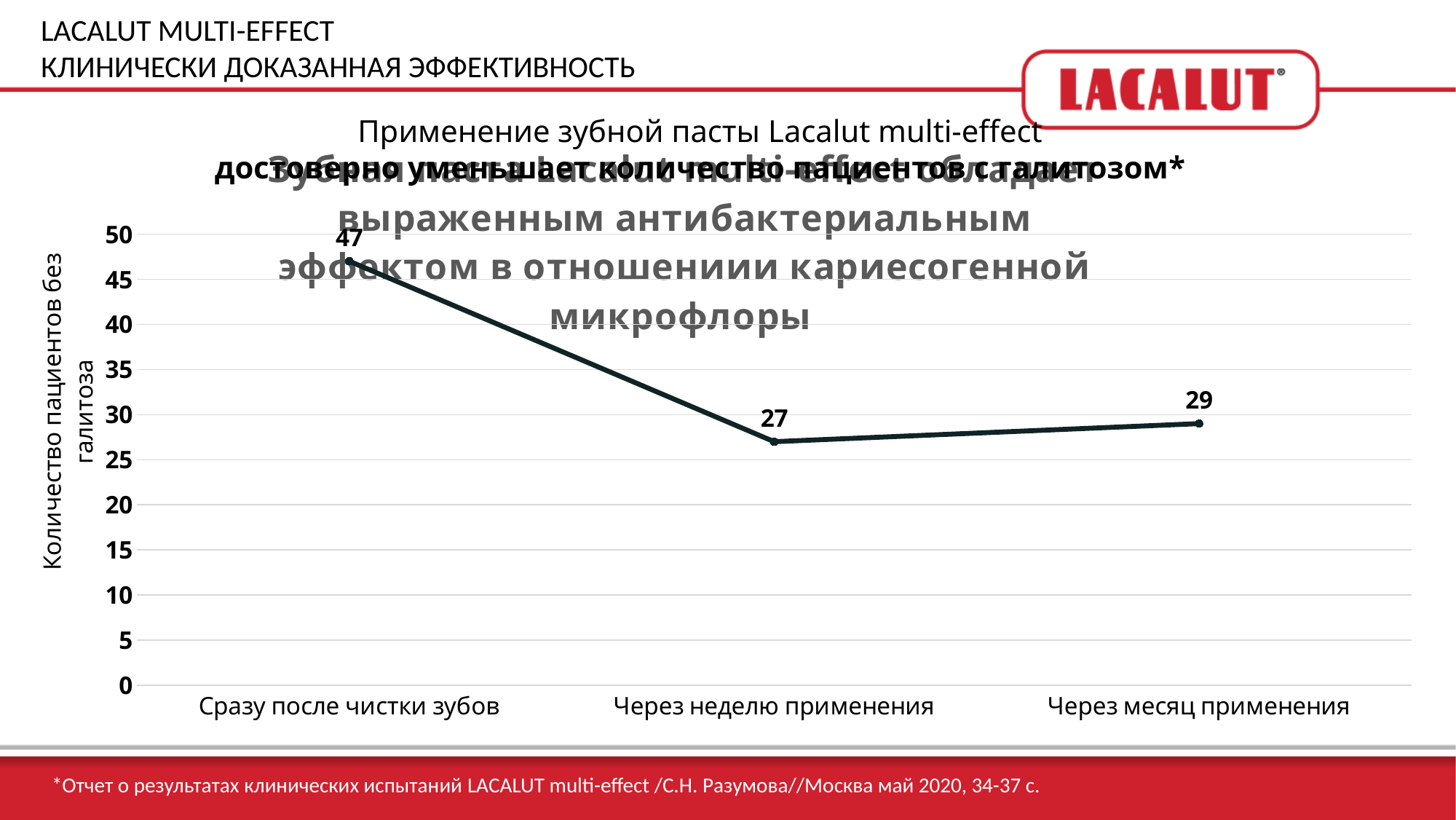
What is the difference between the values for "Через месяц применения" and "Через неделю применения"? 2 Is the value for "Через неделю применения" greater or less than 30? less What is the value for "Через месяц применения"? 29 How many data points are plotted on the chart? 3 What is the label of the vertical axis? Количество пациентов без галитоза Which category has the highest value? Сразу после чистки зубов What is the value for "Через неделю применения"? 27 What kind of chart is shown on the slide? line chart Which is larger: the value for "Сразу после чистки зубов" or the value for "Через месяц применения"? Сразу после чистки зубов Which category has the lowest value? Через неделю применения What is the difference between the values for "Сразу после чистки зубов" and "Через неделю применения"? 20 What is the value for "Сразу после чистки зубов"? 47